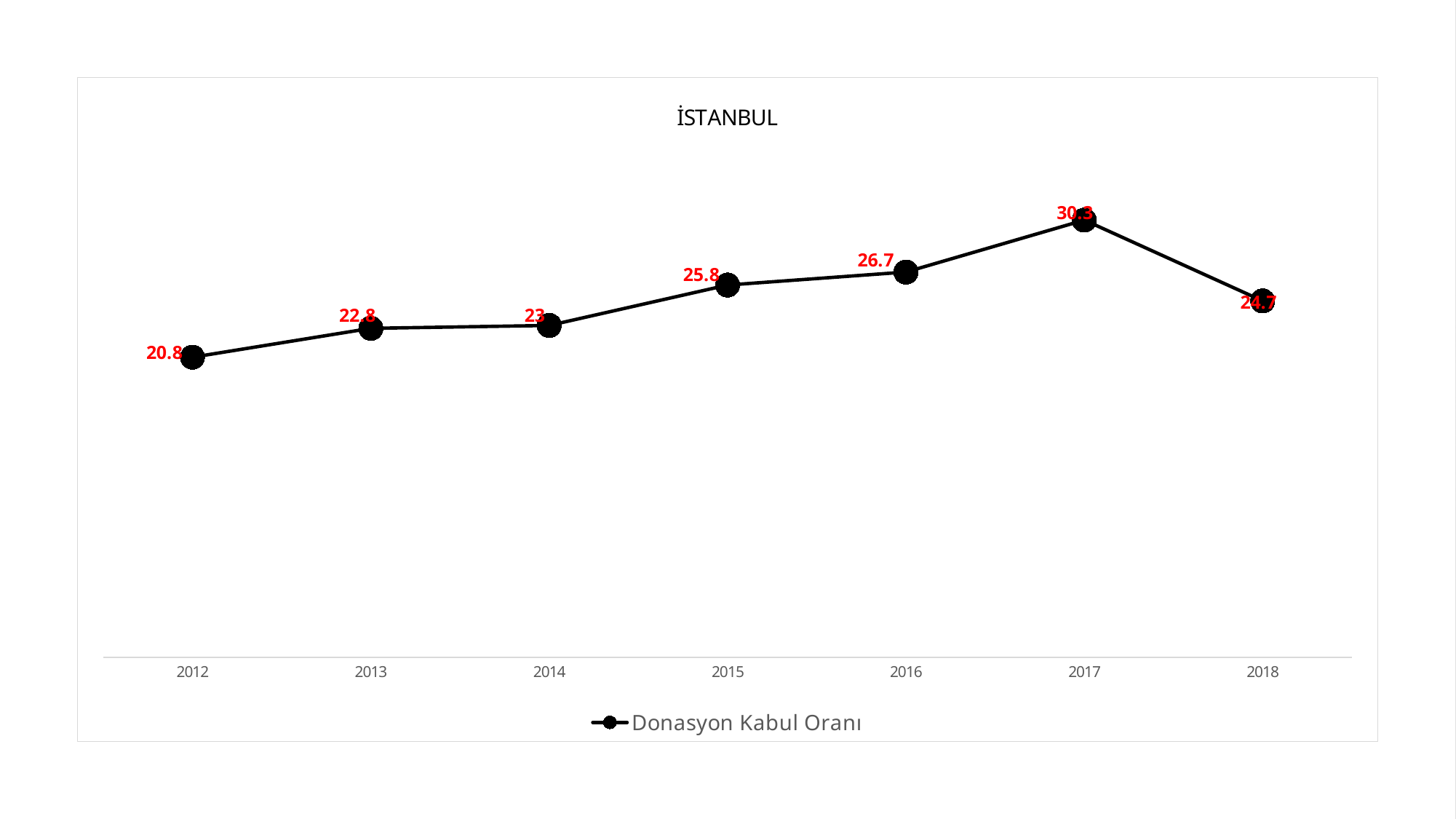
What is the Donasyon Kabul Oranı value for 2012? 20.8 What is the Donasyon Kabul Oranı value for 2018? 24.7 What is the difference between the 2017 value and the 2018 value? 5.6 What is the Donasyon Kabul Oranı value for 2015? 25.8 How many years are plotted on the x axis? 7 How many series does the legend list? 1 Which year has the highest Donasyon Kabul Oranı? 2017 What kind of chart is shown? Line chart What is the difference between the 2016 value and the 2012 value? 5.9 Which year has the lowest Donasyon Kabul Oranı? 2012 What is the title of the chart? İSTANBUL Which year has a larger value, 2014 or 2016? 2016